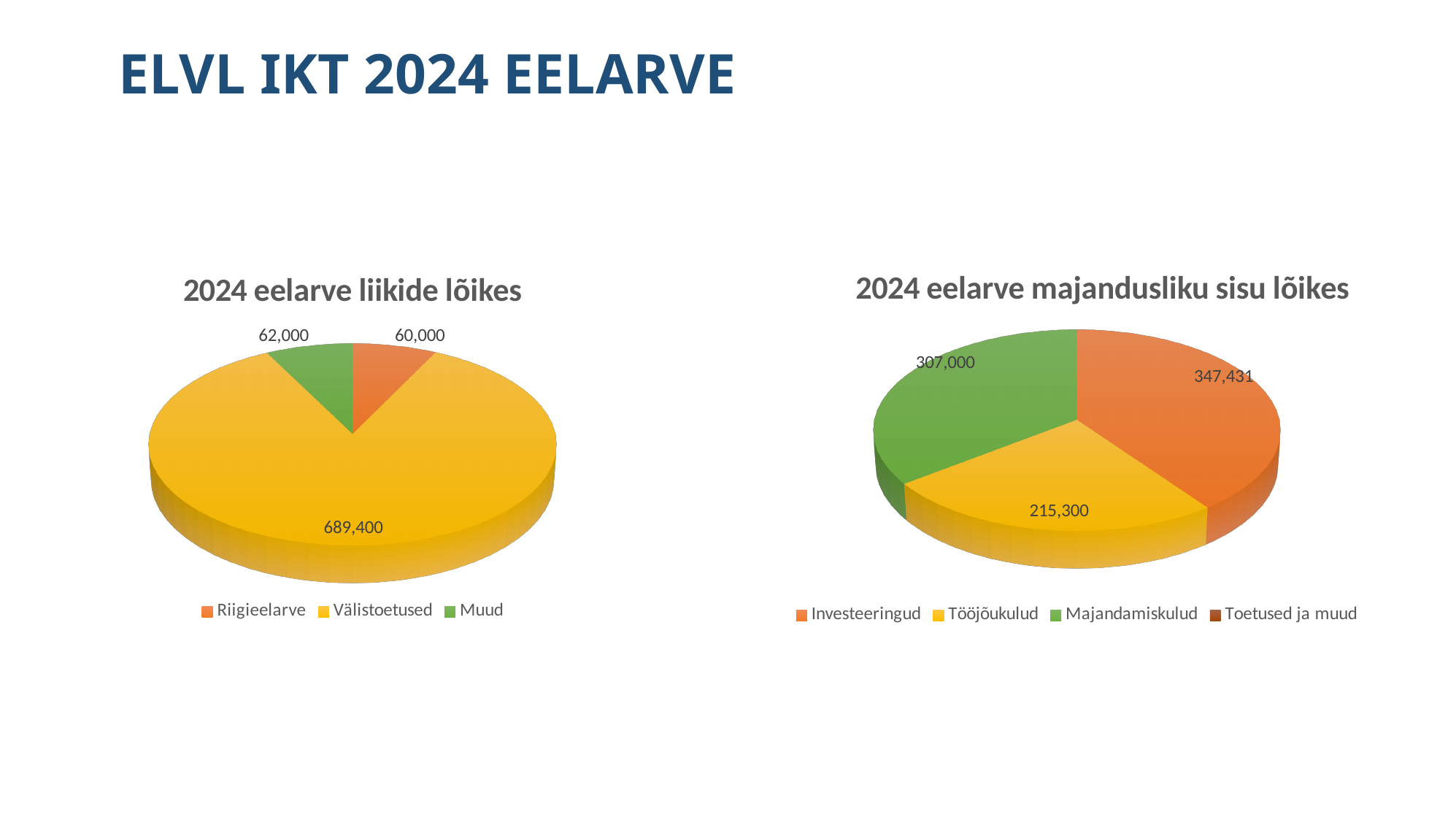
In the chart titled '2024 eelarve liikide lõikes', what is the value for Riigieelarve? 60,000 In the chart titled '2024 eelarve liikide lõikes', what is the difference between the values for Muud and Riigieelarve? 2,000 In the chart titled '2024 eelarve liikide lõikes', what is the total of the three labelled slices? 811,400 In the chart titled '2024 eelarve majandusliku sisu lõikes', what is the value for Majandamiskulud? 307,000 In the chart titled '2024 eelarve majandusliku sisu lõikes', what is the difference between Investeeringud and Majandamiskulud? 40,431 How many entries does the legend of the chart titled '2024 eelarve majandusliku sisu lõikes' list? 4 In the chart titled '2024 eelarve majandusliku sisu lõikes', which is larger: Majandamiskulud or Tööjõukulud? Majandamiskulud In the chart titled '2024 eelarve majandusliku sisu lõikes', which category has the largest slice? Investeeringud What kind of chart is the chart titled '2024 eelarve liikide lõikes'? Pie chart In the chart titled '2024 eelarve majandusliku sisu lõikes', what is the value for Tööjõukulud? 215,300 In the chart titled '2024 eelarve liikide lõikes', which category has the largest slice? Välistoetused In the chart titled '2024 eelarve liikide lõikes', what is the value for Välistoetused? 689,400